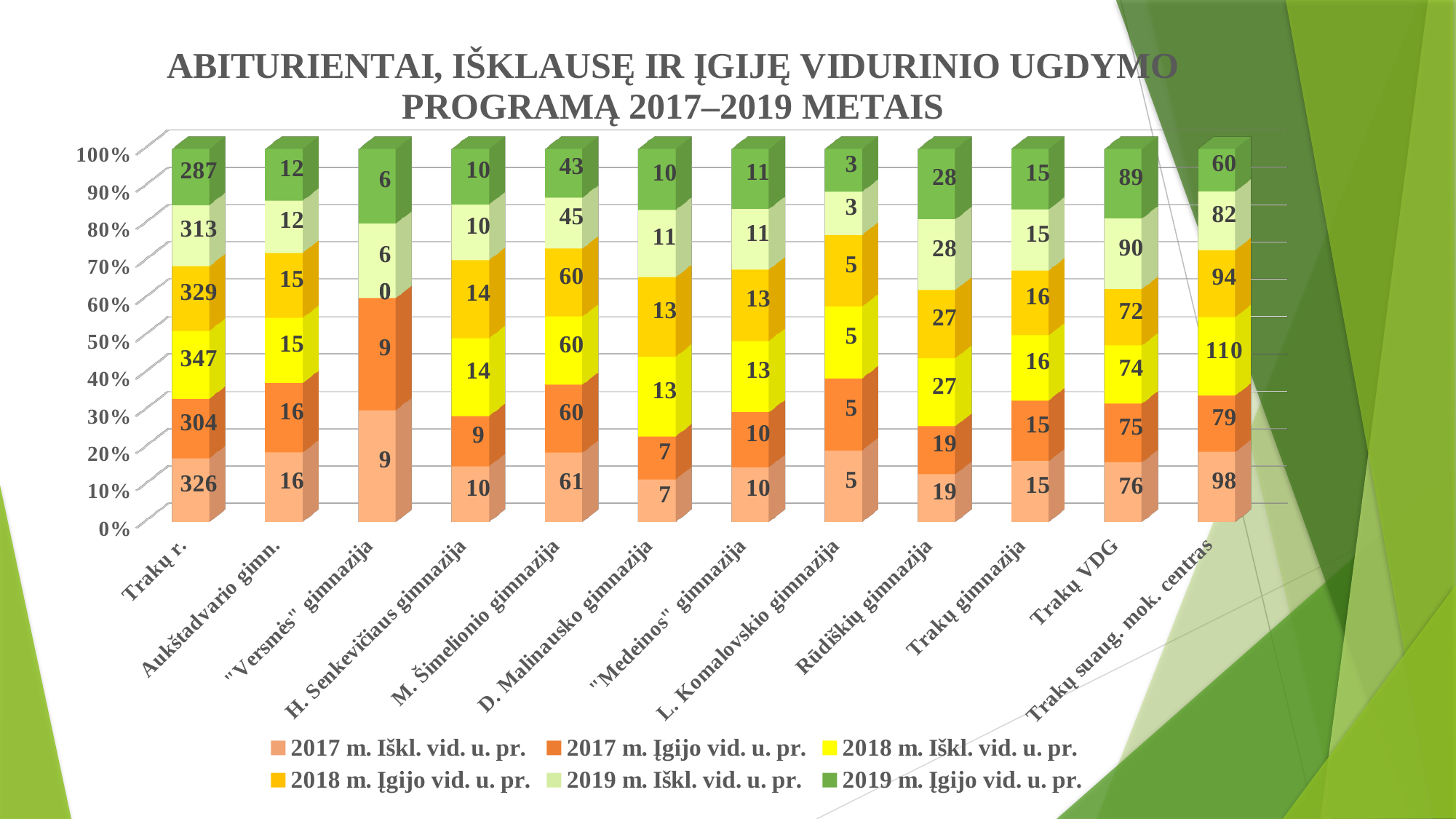
What is the difference between "2017 m. Iškl. vid. u. pr." and "2017 m. Įgijo vid. u. pr." for Trakų suaug. mok. centras? 19 What is the value of "2019 m. Įgijo vid. u. pr." for Trakų r.? 287 What is the value of "2018 m. Įgijo vid. u. pr." for Rūdiškių gimnazija? 27 Excluding Trakų r., which institution has the highest value for "2018 m. Iškl. vid. u. pr."? Trakų suaug. mok. centras Which institution has the lowest value for "2019 m. Įgijo vid. u. pr."? L. Komalovskio gimnazija How many series does the legend list? 6 What is the value of "2019 m. Iškl. vid. u. pr." for Trakų VDG? 90 How many categories (institutions) are shown along the x axis? 12 What kind of chart is shown on the slide? stacked bar chart Which is larger for M. Šimelionio gimnazija: "2019 m. Iškl. vid. u. pr." or "2019 m. Įgijo vid. u. pr."? 2019 m. Iškl. vid. u. pr. What is the value of "2017 m. Iškl. vid. u. pr." for Trakų suaug. mok. centras? 98 What is the title of the chart? ABITURIENTAI, IŠKLAUSĘ IR ĮGIJĘ VIDURINIO UGDYMO PROGRAMĄ 2017–2019 METAIS